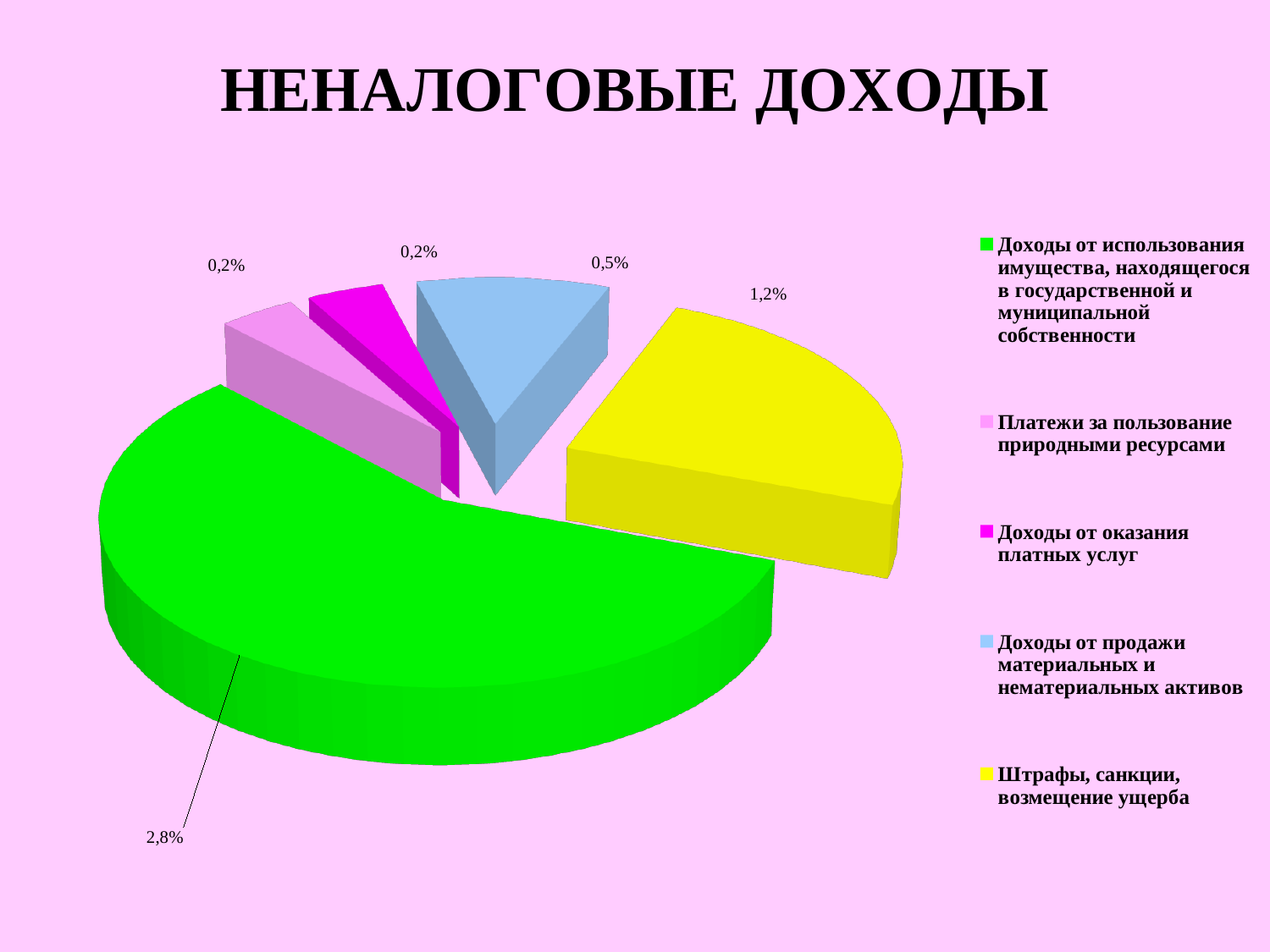
How many slices does the pie chart have? 5 What is the difference between the values for "Доходы от использования имущества, находящегося в государственной и муниципальной собственности" and "Штрафы, санкции, возмещение ущерба"? 1,6% What value is shown for "Доходы от оказания платных услуг"? 0,2% Which category has the largest slice of the pie? Доходы от использования имущества, находящегося в государственной и муниципальной собственности What is the difference between the values for "Доходы от продажи материальных и нематериальных активов" and "Доходы от оказания платных услуг"? 0,3% What kind of chart is shown on the slide? pie chart What value is shown for "Доходы от продажи материальных и нематериальных активов"? 0,5% Which is larger: "Штрафы, санкции, возмещение ущерба" or "Доходы от продажи материальных и нематериальных активов"? Штрафы, санкции, возмещение ущерба What is the title of the chart? НЕНАЛОГОВЫЕ ДОХОДЫ What value is shown for "Доходы от использования имущества, находящегося в государственной и муниципальной собственности"? 2,8% What value is shown for "Штрафы, санкции, возмещение ущерба"? 1,2% What colour is the slice for "Платежи за пользование природными ресурсами"? light pink